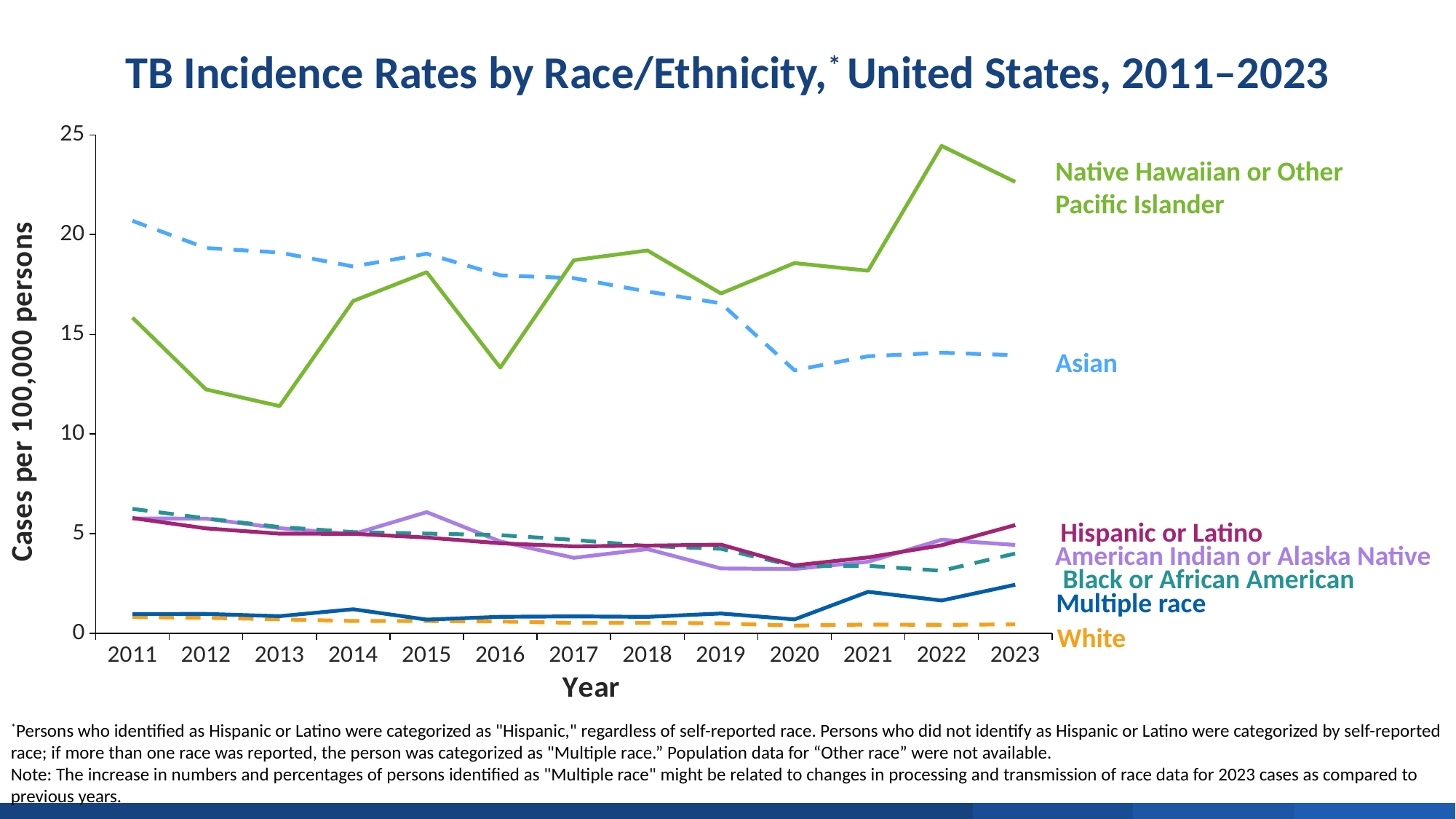
How many years are plotted along the x axis? 13 What kind of chart is shown on the slide? line chart Which race/ethnicity group has the highest TB incidence rate in 2023? Native Hawaiian or Other Pacific Islander Is the TB incidence rate for Asian persons in 2020 greater or less than 15? less Which race/ethnicity group has the lowest TB incidence rate in 2023? White Is the TB incidence rate for Native Hawaiian or Other Pacific Islander in 2022 greater or less than 20? greater Is the TB incidence rate for Native Hawaiian or Other Pacific Islander in 2013 greater or less than 15? less How many race/ethnicity series are plotted on the chart? 7 Which race/ethnicity group has the highest TB incidence rate in 2011? Asian What is the label of the y axis? Cases per 100,000 persons In 2016, which group has the higher TB incidence rate: Asian or Native Hawaiian or Other Pacific Islander? Asian Does the TB incidence rate for Asian persons generally rise or fall from 2011 to 2023? fall